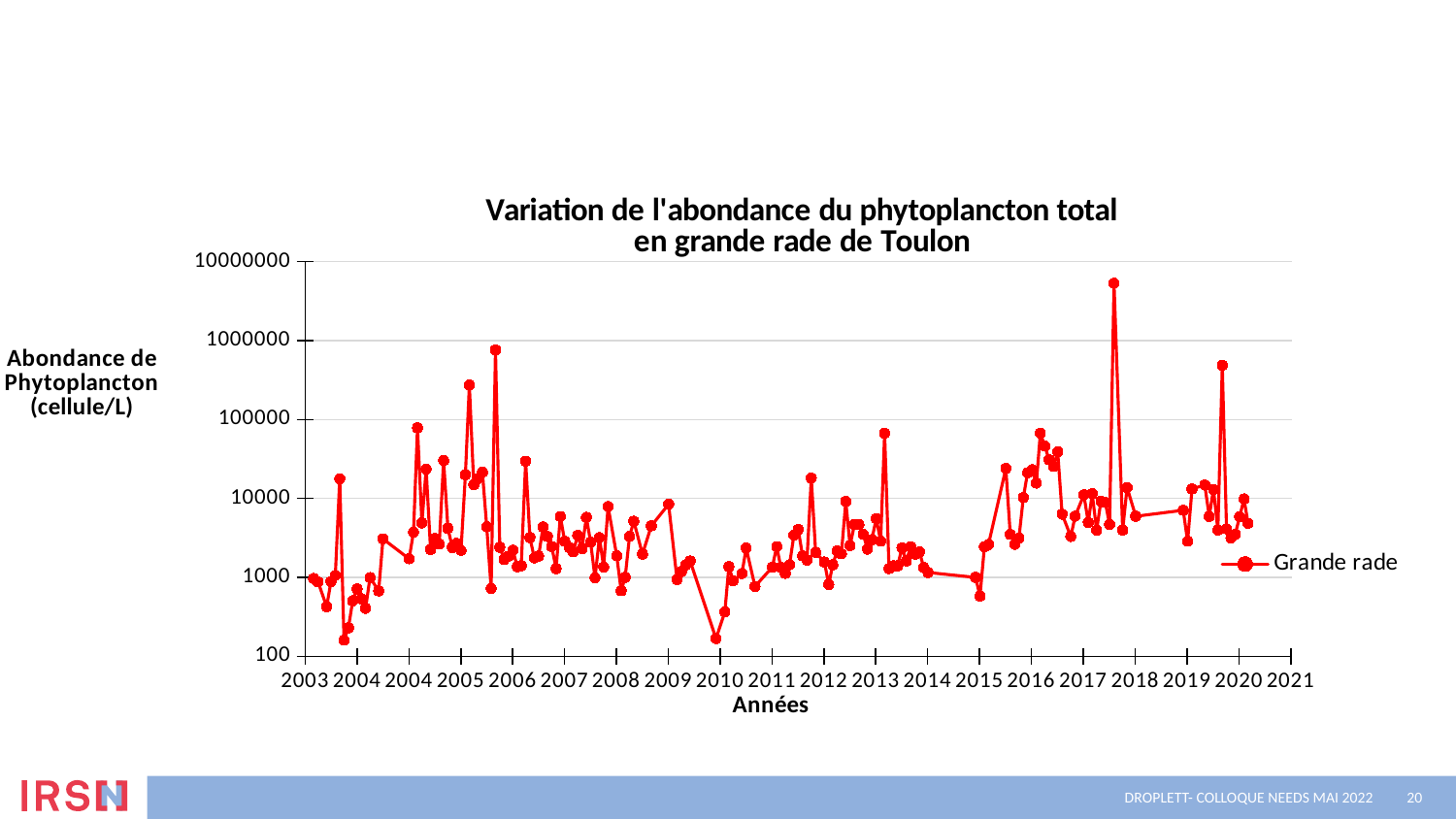
Which is larger: the peak between 2017 and 2018 or the peak between 2005 and 2006? the peak between 2017 and 2018 What is the name of the series shown in the legend? Grande rade What type of chart is shown on the slide? line chart Is the first data point of the series in 2003 greater or less than 10000? less Is the lowest point of the series, which occurs just before 2010, greater or less than 1000? less Is the spike in the series between 2019 and 2020 greater or less than 100000? greater In which year interval does the series reach its highest value? between 2017 and 2018 What is the title of the chart? Variation de l'abondance du phytoplancton total en grande rade de Toulon How many series does the legend list? 1